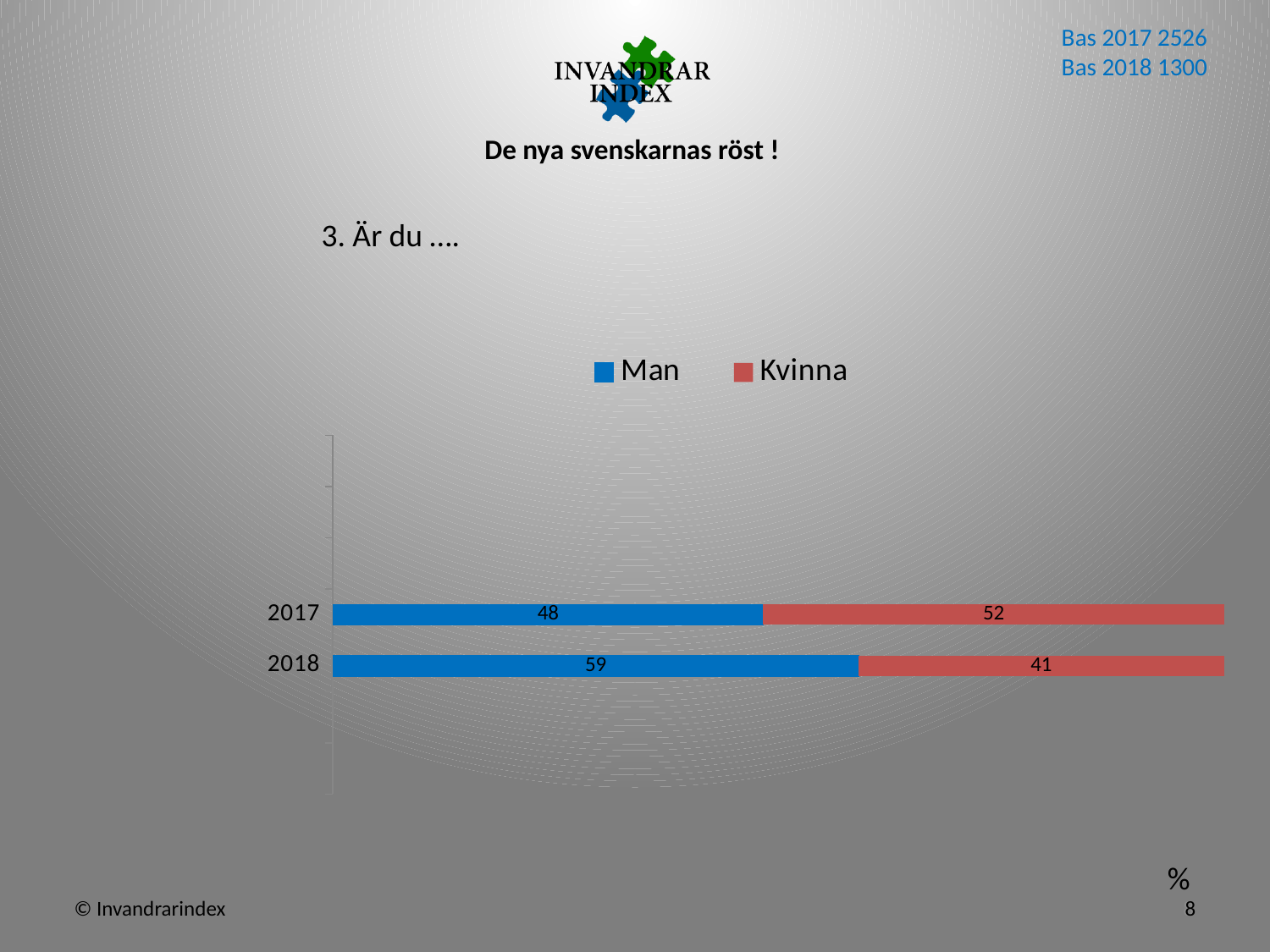
In which year is the value for Kvinna lowest? 2018 How many series does the legend list? 2 What is the value for Man in 2017? 48 What kind of chart is shown? Stacked bar chart What is the value for Kvinna in 2017? 52 In which year is the value for Man highest? 2018 How many years are shown on the chart? 2 Which is larger in 2017, Man or Kvinna? Kvinna What is the value for Kvinna in 2018? 41 What is the difference between the Man values for 2018 and 2017? 11 What is the value for Man in 2018? 59 What is the total of the stacked bar for 2018? 100